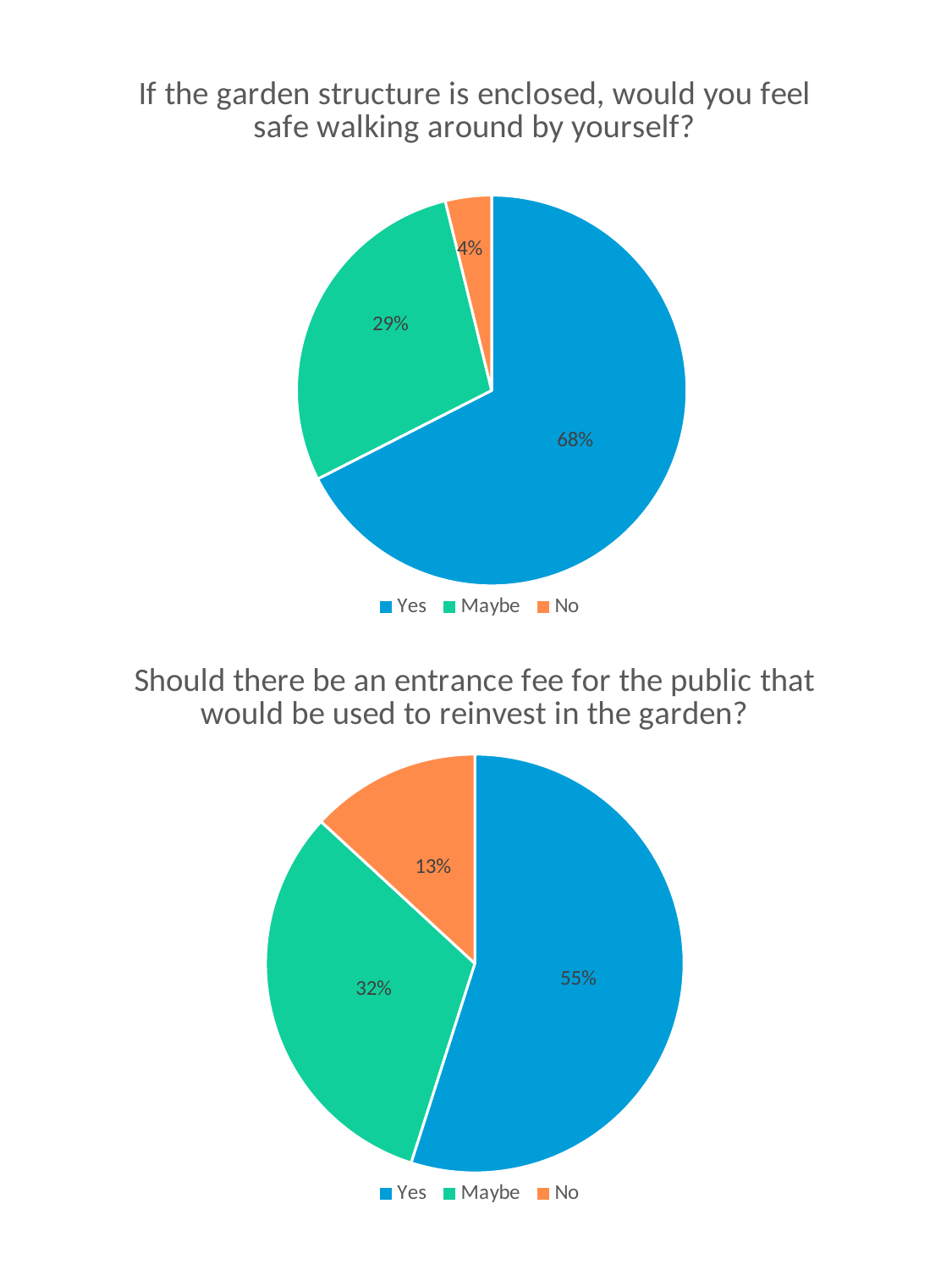
In the top pie chart about feeling safe walking around, what share of responses is 'Maybe'? 29% In the top pie chart about feeling safe walking around, what share of responses is 'Yes'? 68% In the top pie chart about feeling safe walking around, what is the difference between the 'Yes' and 'Maybe' shares? 39% In the bottom pie chart about an entrance fee, what share of responses is 'No'? 13% What type of chart is the top chart about feeling safe walking around? Pie chart In the bottom pie chart about an entrance fee, what share of responses is 'Yes'? 55% Which chart has the larger 'No' share, the top chart about feeling safe or the bottom chart about an entrance fee? The bottom chart about an entrance fee In the top pie chart about feeling safe walking around, what share of responses is 'No'? 4% In the top pie chart about feeling safe walking around, which response has the smallest share? No In the bottom pie chart about an entrance fee, which response has the largest share? Yes In the bottom pie chart about an entrance fee, what is the difference between the 'Maybe' and 'No' shares? 19% How many slices does the bottom pie chart about an entrance fee have? 3